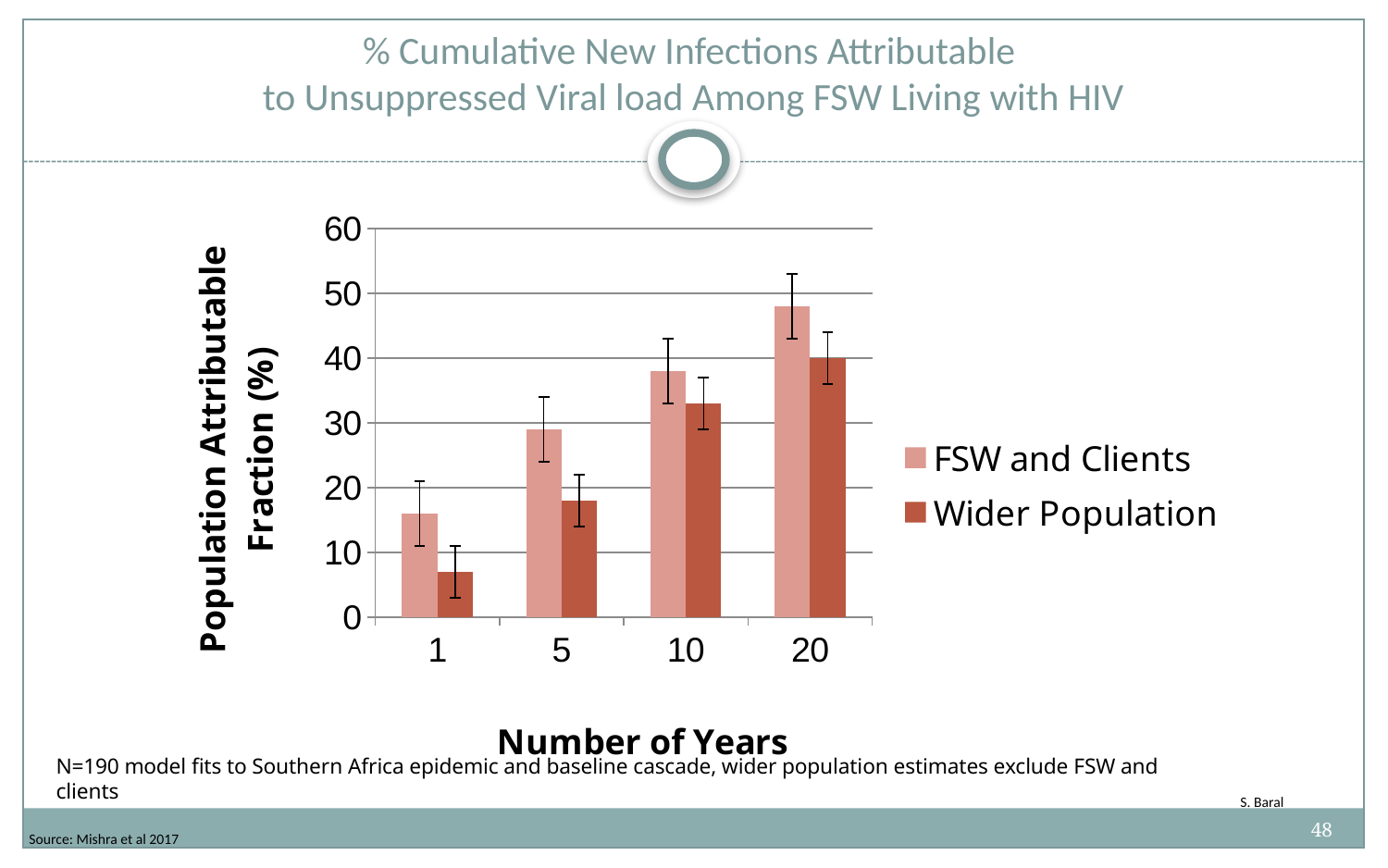
For which number of years is the Wider Population value lowest? 1 What is the title of the x axis? Number of Years For which number of years is the FSW and Clients value highest? 20 Is the FSW and Clients value at 20 years greater or less than 40? greater What is the title of the y axis? Population Attributable Fraction (%) How many series does the legend list? 2 Do the Wider Population values rise or fall as the number of years increases? rise What kind of chart is shown on the slide? bar chart At 1 year, which series has the larger value: FSW and Clients or Wider Population? FSW and Clients How many categories are shown on the x axis? 4 Is the FSW and Clients value at 5 years greater or less than 20? greater Is the Wider Population value at 1 year greater or less than 10? less